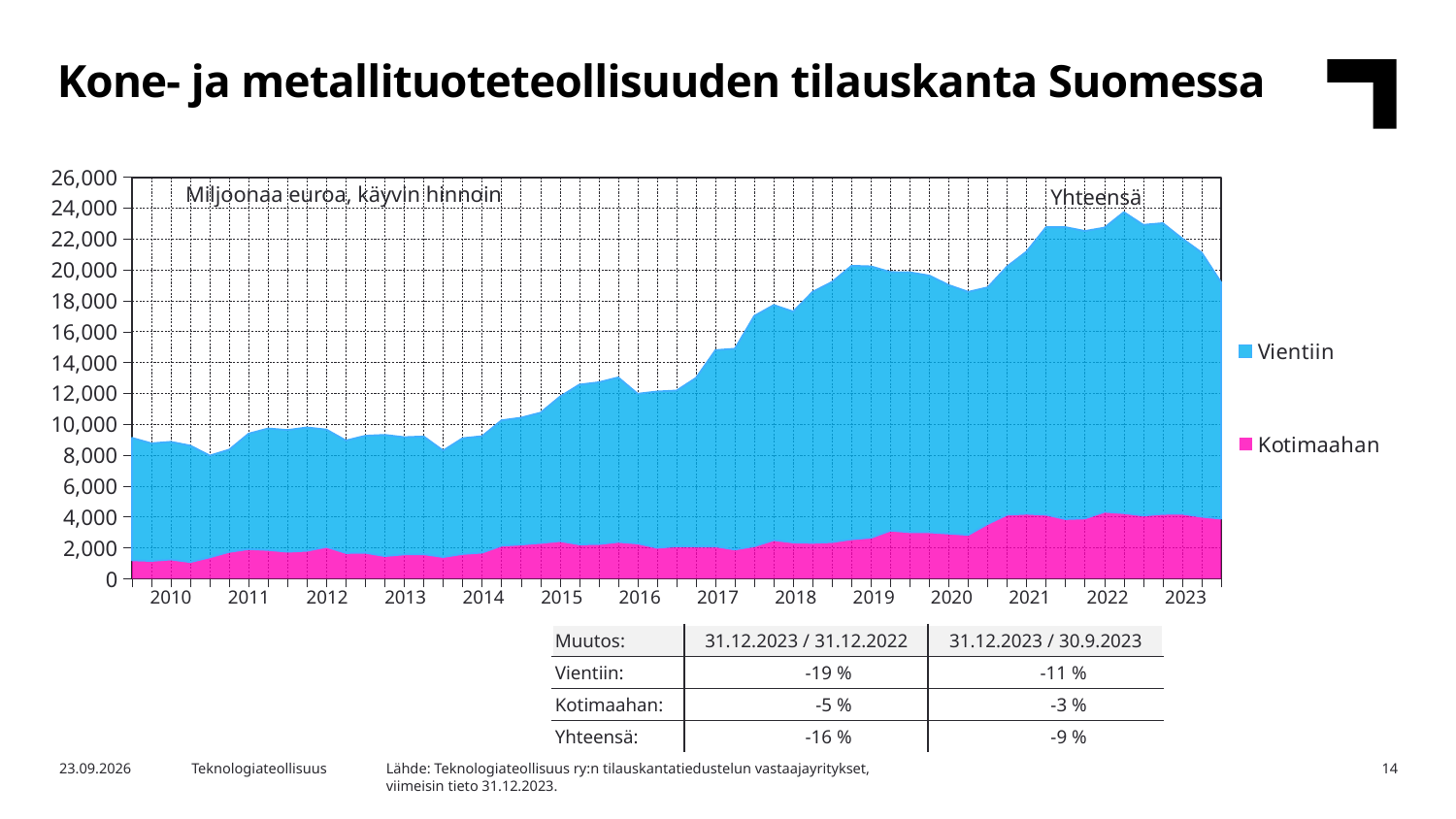
How many series does the chart legend list? 2 What are the two series named in the chart legend? Vientiin and Kotimaahan Which series is larger throughout the chart, Vientiin or Kotimaahan? Vientiin What kind of chart is shown on the slide? Area chart Is the Kotimaahan value in 2021 greater or less than 6,000? less Is the total order backlog (Yhteensä) at the start of 2010 greater or less than 10,000? less How many years are labelled on the x axis of the chart? 14 In which year does the total order backlog (Yhteensä) reach its highest point? 2022 Does the total order backlog rise or fall from 2020 to 2022? Rise Is the Kotimaahan value in 2021 greater or less than 2,000? greater What unit is stated in the annotation at the top left of the chart? Miljoonaa euroa, käyvin hinnoin